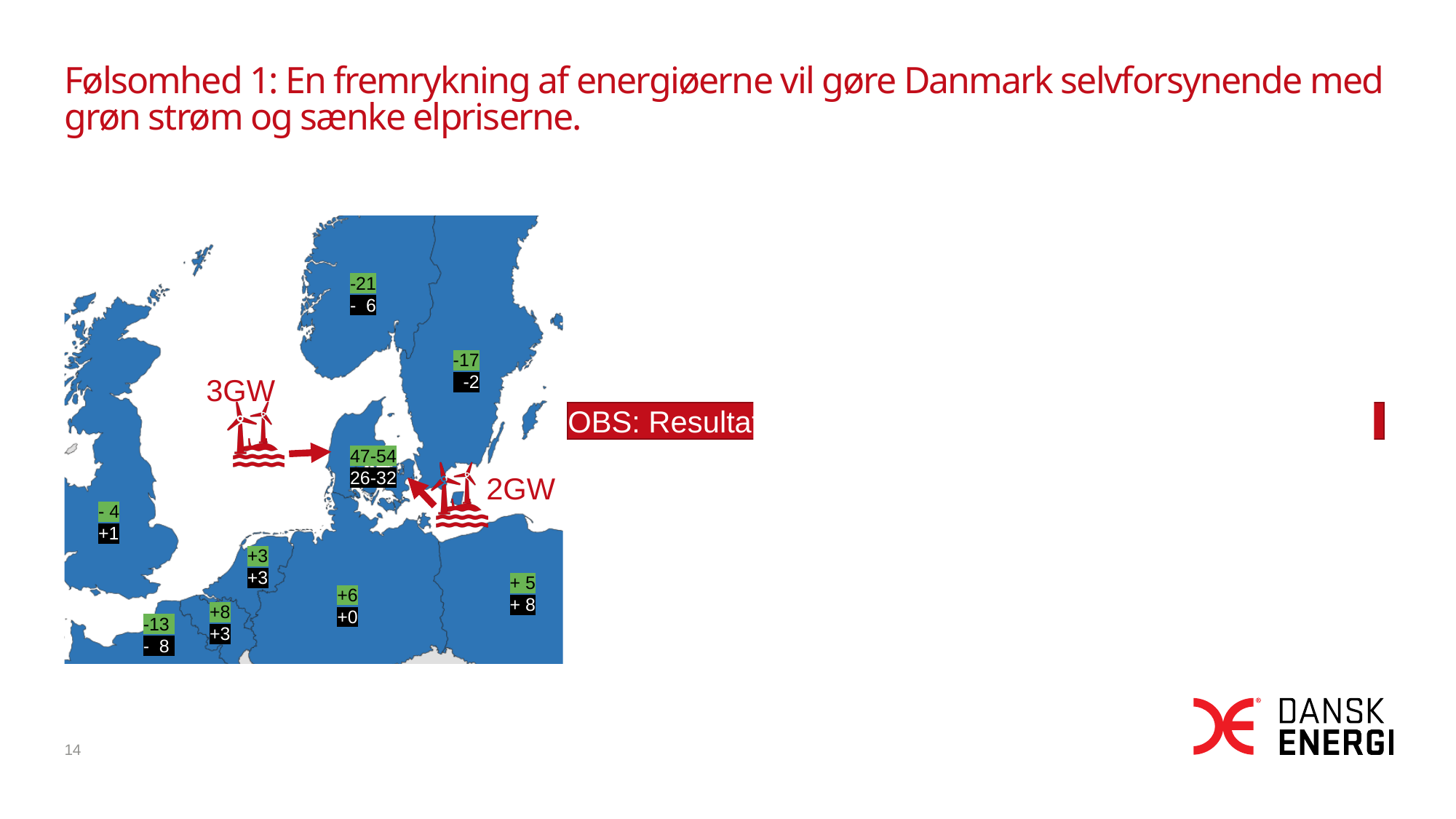
On the map, what is the black value shown on Denmark, where the two red arrows point? 26-32 On the map, what is the black value shown on the northernmost country (top of the map)? - 6 On the map, what capacity is written next to the wind turbine icon in the North Sea, to the left of Denmark? 3GW On the map, what is the green value shown on the country at the bottom right? + 5 On the map, what is the black value shown on the country at the bottom right? + 8 On the map, what is the green value shown on Denmark, where the two red arrows point? 47-54 Which green value on the map is the highest? 47-54 On the map, what is the green value shown on the northernmost country (top of the map)? -21 On the map, what capacity is written next to the wind turbine icon in the Baltic Sea, to the right of Denmark? 2GW What two colours are used for the value labels on the map? Green and black How many green/black value label pairs are placed on the map? 9 Which green value on the map is the lowest? -21